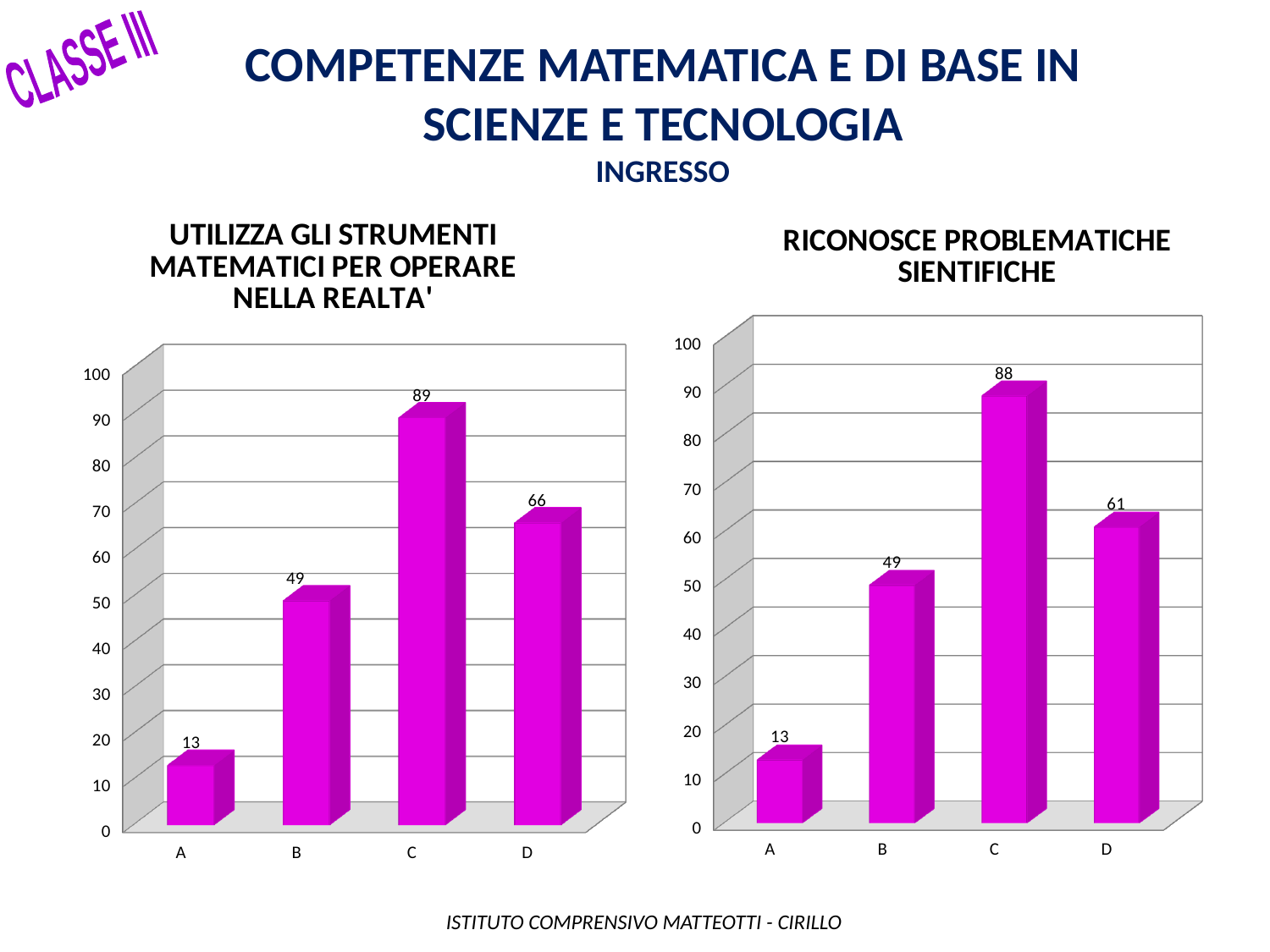
In the left chart 'UTILIZZA GLI STRUMENTI MATEMATICI PER OPERARE NELLA REALTA'', which category has the lowest value? A In the right chart 'RICONOSCE PROBLEMATICHE SIENTIFICHE', which is larger, the value for B or the value for D? D In the right chart 'RICONOSCE PROBLEMATICHE SIENTIFICHE', what is the difference between the values for B and A? 36 In the left chart 'UTILIZZA GLI STRUMENTI MATEMATICI PER OPERARE NELLA REALTA'', what is the difference between the values for C and D? 23 In the left chart 'UTILIZZA GLI STRUMENTI MATEMATICI PER OPERARE NELLA REALTA'', what is the value for category C? 89 In the right chart 'RICONOSCE PROBLEMATICHE SIENTIFICHE', which category has the highest value? C In the right chart 'RICONOSCE PROBLEMATICHE SIENTIFICHE', what is the value for category D? 61 How many categories are shown in the right chart 'RICONOSCE PROBLEMATICHE SIENTIFICHE'? 4 What is the title of the right chart on the slide? RICONOSCE PROBLEMATICHE SIENTIFICHE In the left chart 'UTILIZZA GLI STRUMENTI MATEMATICI PER OPERARE NELLA REALTA'', is the value for B greater or less than 50? less What kind of chart is the left chart 'UTILIZZA GLI STRUMENTI MATEMATICI PER OPERARE NELLA REALTA''? Bar chart In the left chart 'UTILIZZA GLI STRUMENTI MATEMATICI PER OPERARE NELLA REALTA'', what is the value for category A? 13